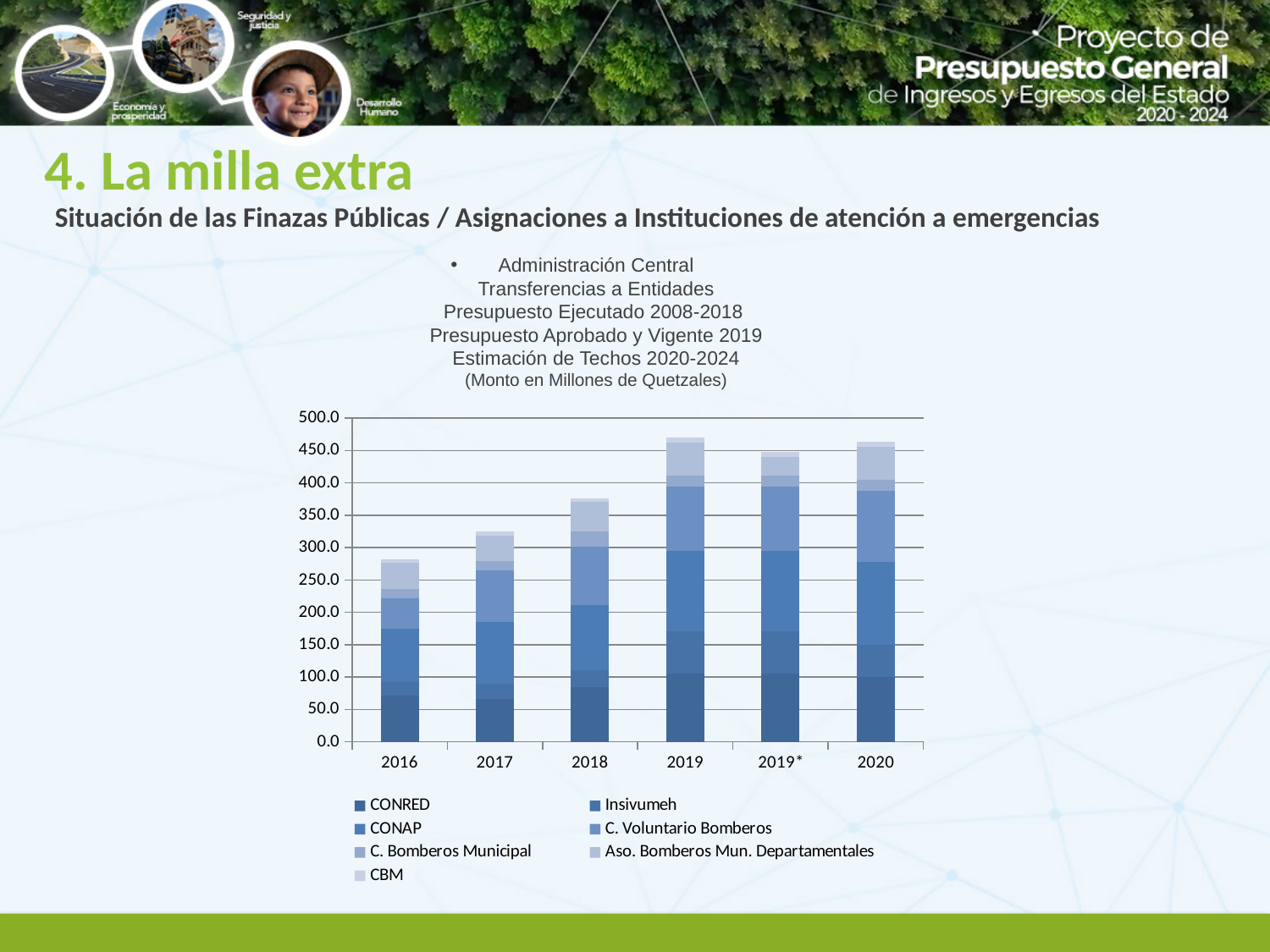
Which has the larger total stacked bar, 2016 or 2018? 2018 Is the total of the stacked bar for 2018 greater or less than 350.0? greater Is the total of the stacked bar for 2016 greater or less than 300.0? less What kind of chart is shown on the slide? Stacked bar chart In what unit are the amounts in the chart expressed, according to the chart title? Millones de Quetzales Is the total of the stacked bar for 2017 greater or less than 300.0? greater Do the total stacked bar values rise or fall from 2016 to 2019? Rise How many year categories are shown on the x axis of the chart? 6 How many series does the chart legend list? 7 Which year has the lowest total stacked bar in the chart? 2016